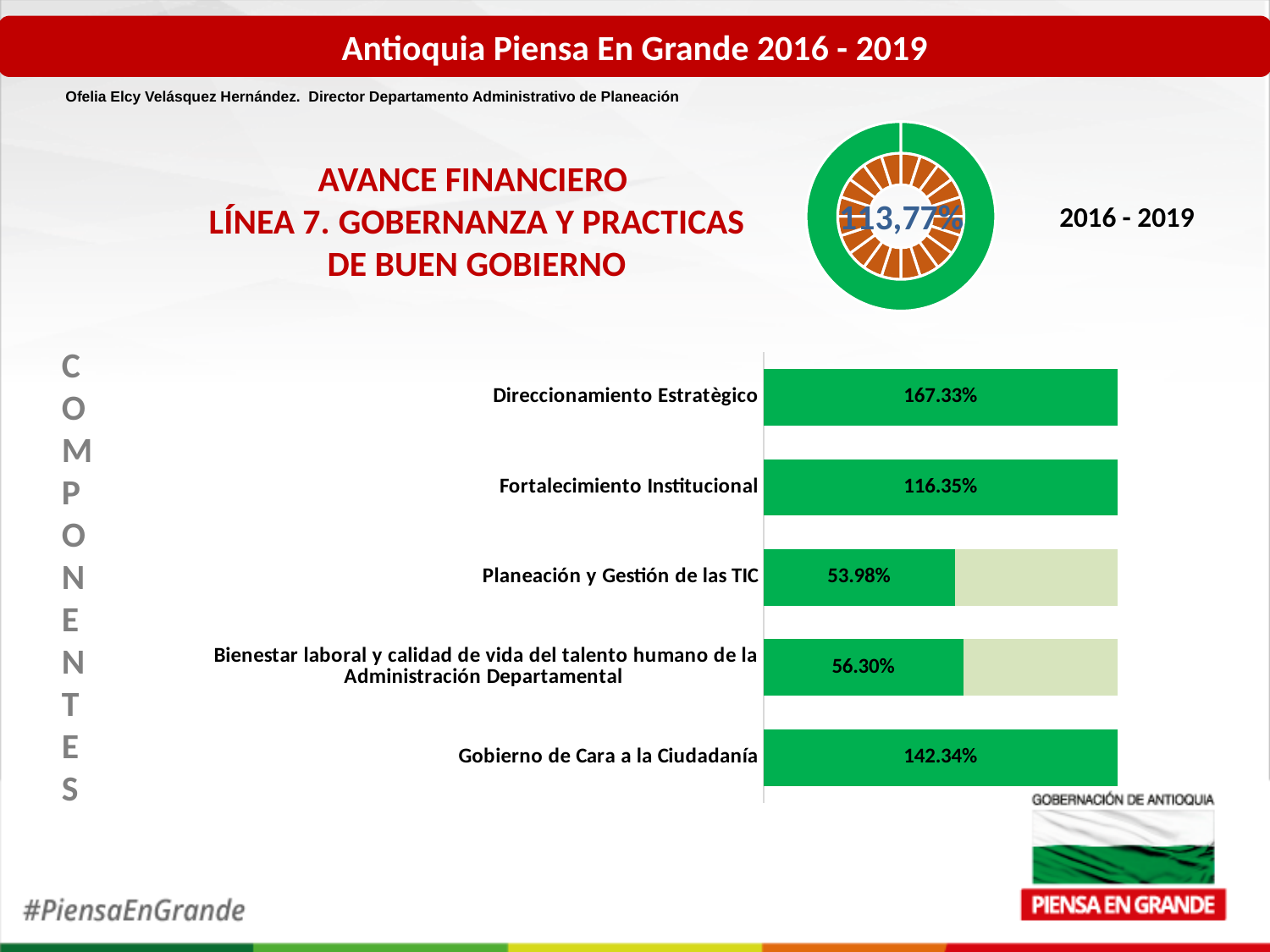
In the bar chart, what is the difference between Direccionamiento Estratègico and Gobierno de Cara a la Ciudadanía? 24.99% In the bar chart, what is the value for Planeación y Gestión de las TIC? 53.98% How many components are shown in the bar chart? 5 In the bar chart, which component has the highest value? Direccionamiento Estratègico In the bar chart, what is the value for Fortalecimiento Institucional? 116.35% In the bar chart, what is the value for Direccionamiento Estratègico? 167.33% In the bar chart, what is the difference between Bienestar laboral y calidad de vida del talento humano de la Administración Departamental and Planeación y Gestión de las TIC? 2.32% In the bar chart, which is larger: Fortalecimiento Institucional or Gobierno de Cara a la Ciudadanía? Gobierno de Cara a la Ciudadanía In the bar chart, which component has the lowest value? Planeación y Gestión de las TIC In the bar chart, what is the value for Gobierno de Cara a la Ciudadanía? 142.34% What kind of chart shows the component values? Bar chart What overall percentage is shown in the donut chart at the top of the slide? 113,77%